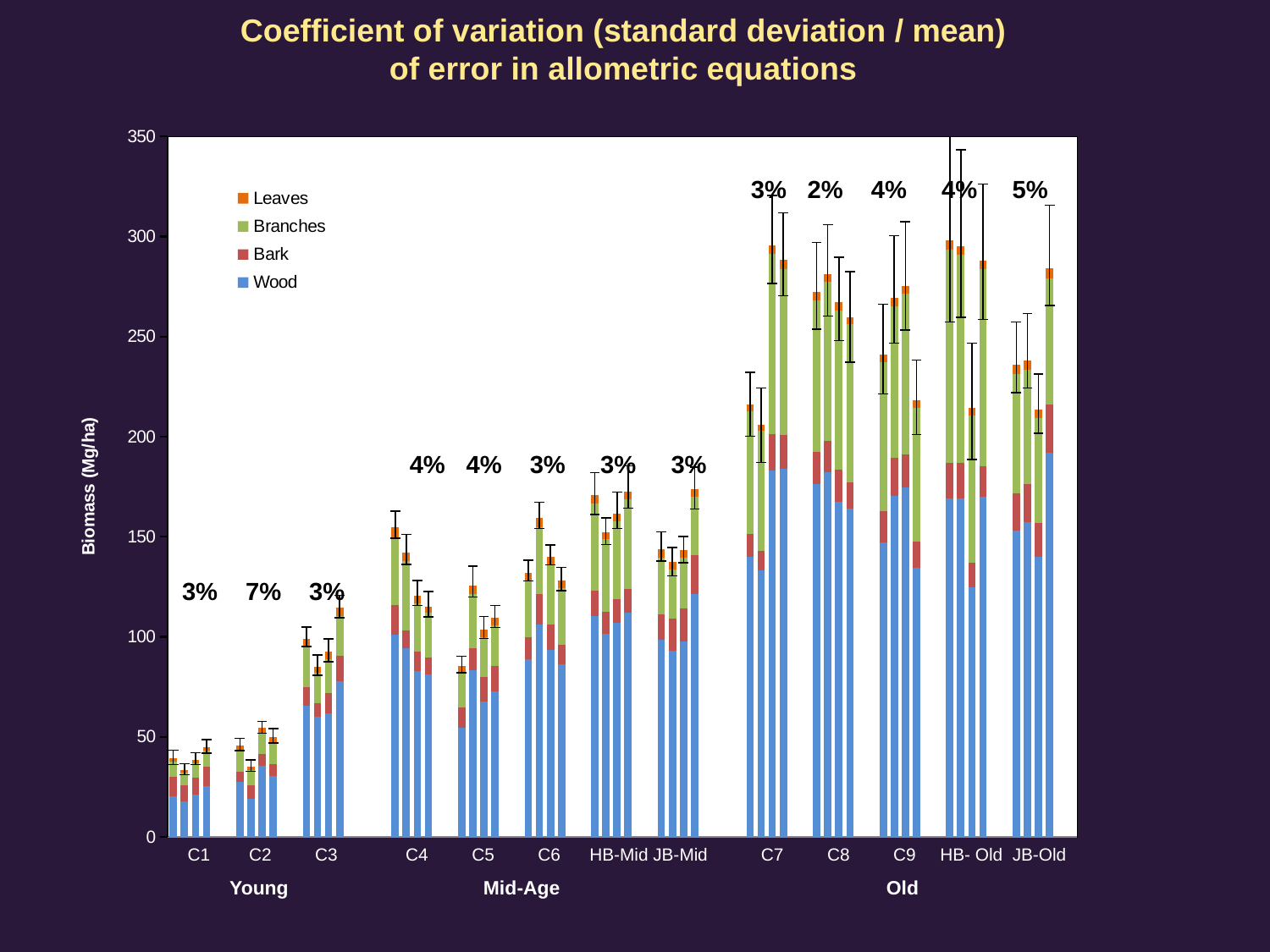
What kind of chart is shown on the slide? bar chart What is the title of the y axis? Biomass (Mg/ha) Which group has taller biomass bars, C1 or C3? C3 How many series does the legend list? 4 What coefficient of variation percentage is printed above the JB-Old group? 5% What coefficient of variation percentage is printed above the C2 group? 7% Is the biomass of the tallest bar in the C7 group greater or less than 250? greater Which site group has the lowest coefficient of variation percentage printed above it? C8 What coefficient of variation percentage is printed above the C8 group? 2% Is the biomass of the tallest bar in the C1 group greater or less than 50? less Which site group has the highest coefficient of variation percentage printed above it? C2 How many site categories are labelled along the x axis? 13